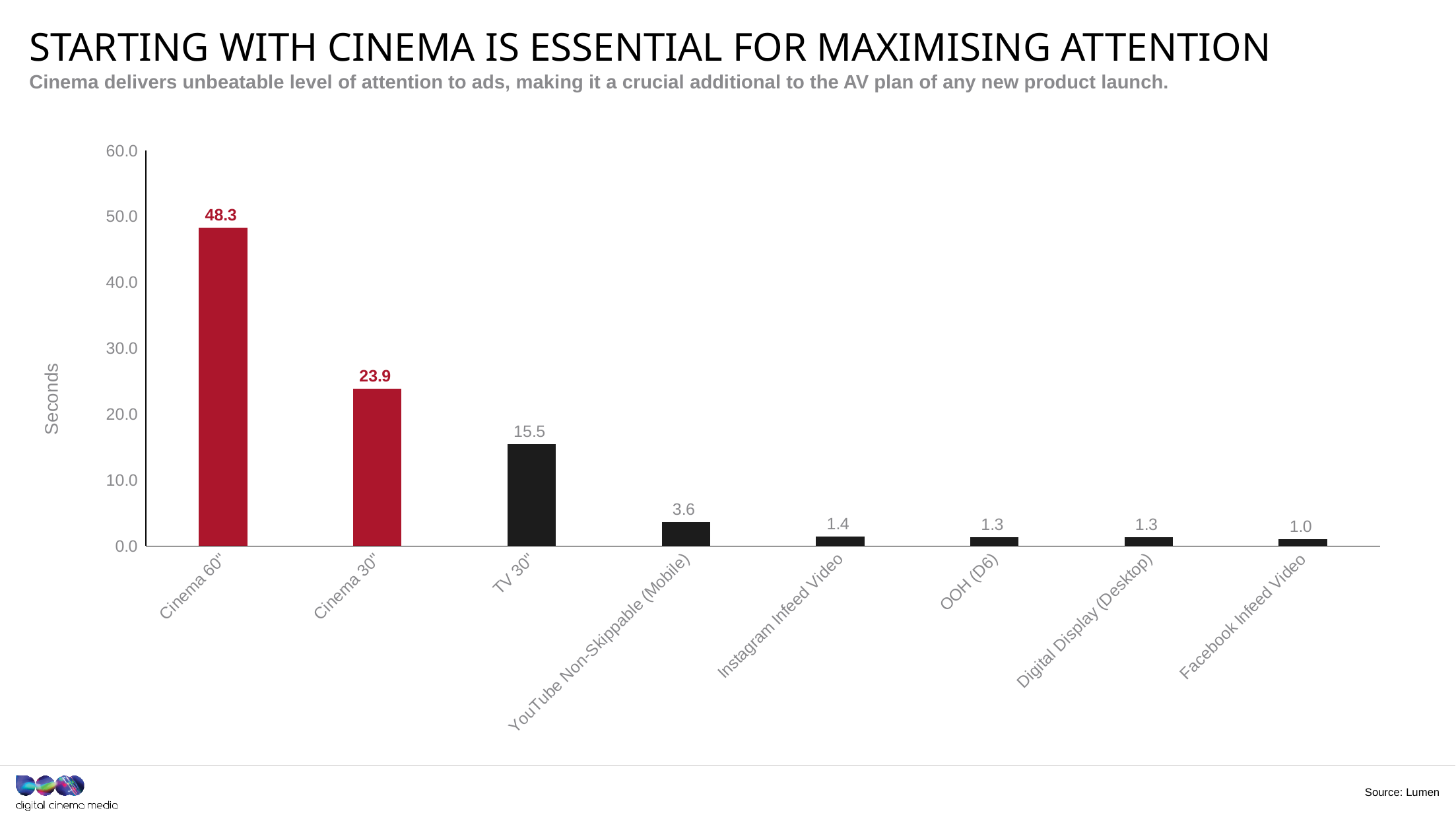
Which category has the highest value? Cinema 60" Do the values rise or fall from left to right along the x axis? Fall What is the label on the vertical axis? Seconds Which is larger, the value for Cinema 30" or the value for TV 30"? Cinema 30" What is the value for Facebook Infeed Video? 1.0 What is the difference between the values for Cinema 60" and Cinema 30"? 24.4 What kind of chart is shown on the slide? Bar chart What is the value for TV 30"? 15.5 What is the value for YouTube Non-Skippable (Mobile)? 3.6 How many categories are shown on the x axis? 8 Which category has the lowest value? Facebook Infeed Video What is the value for Cinema 60"? 48.3